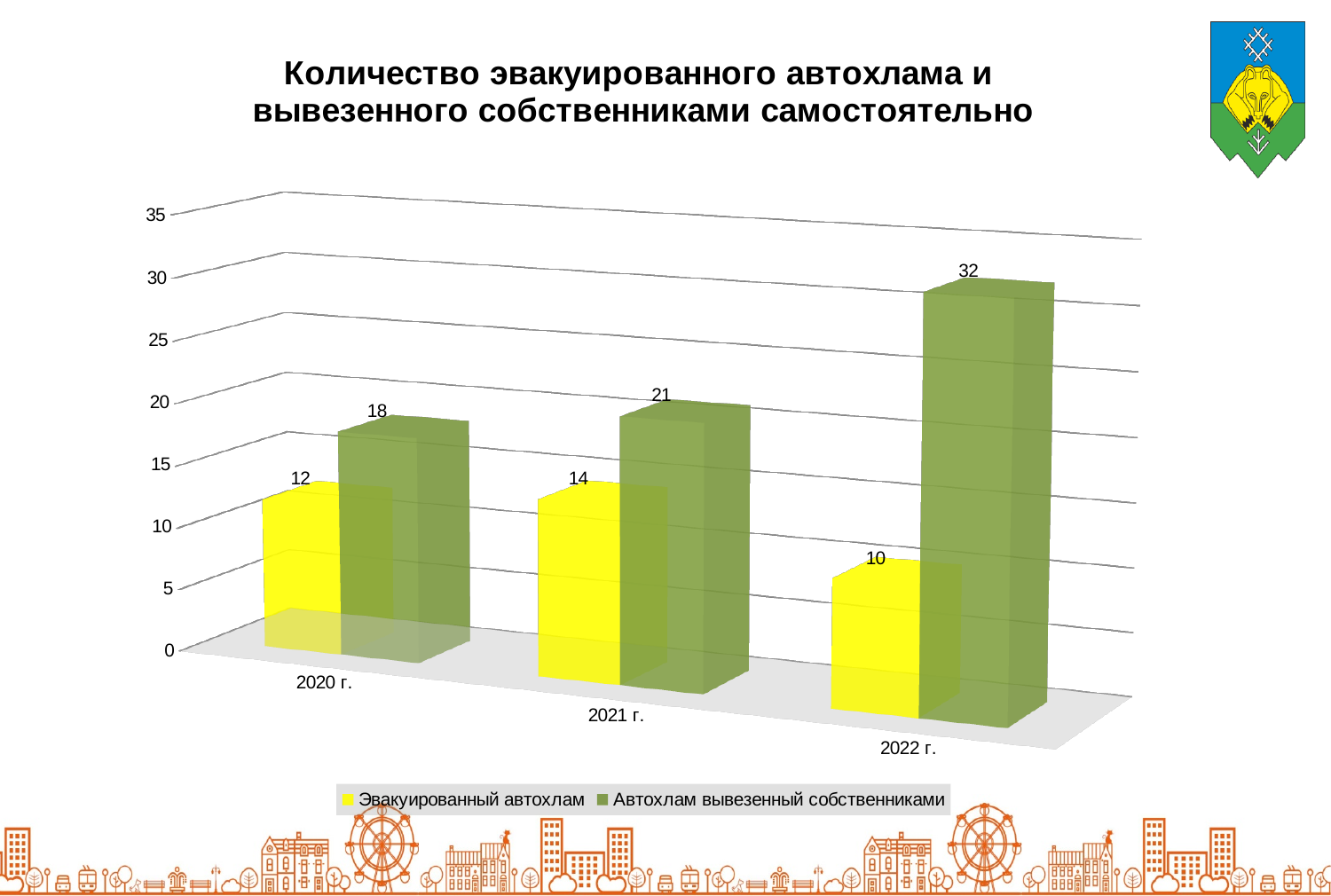
Which is larger in 2021 г.: 'Эвакуированный автохлам' or 'Автохлам вывезенный собственниками'? Автохлам вывезенный собственниками In which year is 'Автохлам вывезенный собственниками' highest? 2022 г. Does 'Автохлам вывезенный собственниками' rise or fall from 2020 г. to 2022 г.? Rise What is the value for 'Эвакуированный автохлам' in 2020 г.? 12 What is the value for 'Эвакуированный автохлам' in 2022 г.? 10 How many series does the legend list? 2 In which year is 'Эвакуированный автохлам' lowest? 2022 г. What is the value for 'Автохлам вывезенный собственниками' in 2021 г.? 21 What is the value for 'Автохлам вывезенный собственниками' in 2022 г.? 32 How many years are shown on the x axis? 3 What is the difference between 'Автохлам вывезенный собственниками' and 'Эвакуированный автохлам' in 2022 г.? 22 What kind of chart is shown on the slide? Bar chart